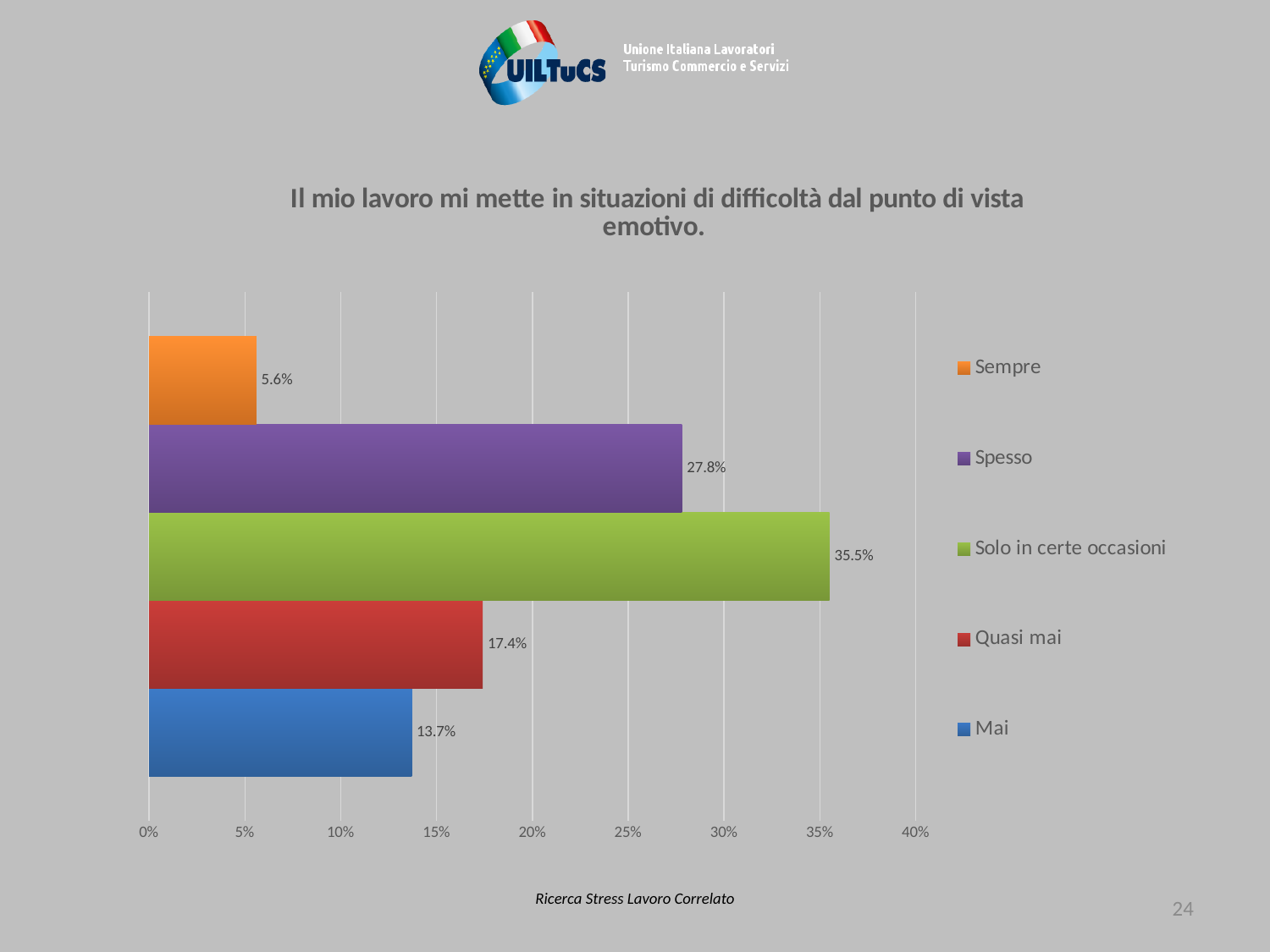
How many categories are shown in the chart? 5 What is the value for "Solo in certe occasioni"? 35.5% Which category has the highest value? Solo in certe occasioni What is the difference between the values for "Spesso" and "Quasi mai"? 10.4% What is the value for "Sempre"? 5.6% What kind of chart is shown on the slide? Bar chart Which is larger, the value for "Quasi mai" or the value for "Mai"? Quasi mai What is the value for "Quasi mai"? 17.4% What colour is the bar for "Solo in certe occasioni"? Green Which category has the lowest value? Sempre What is the value for "Mai"? 13.7% Is the value for "Spesso" greater or less than 25%? greater